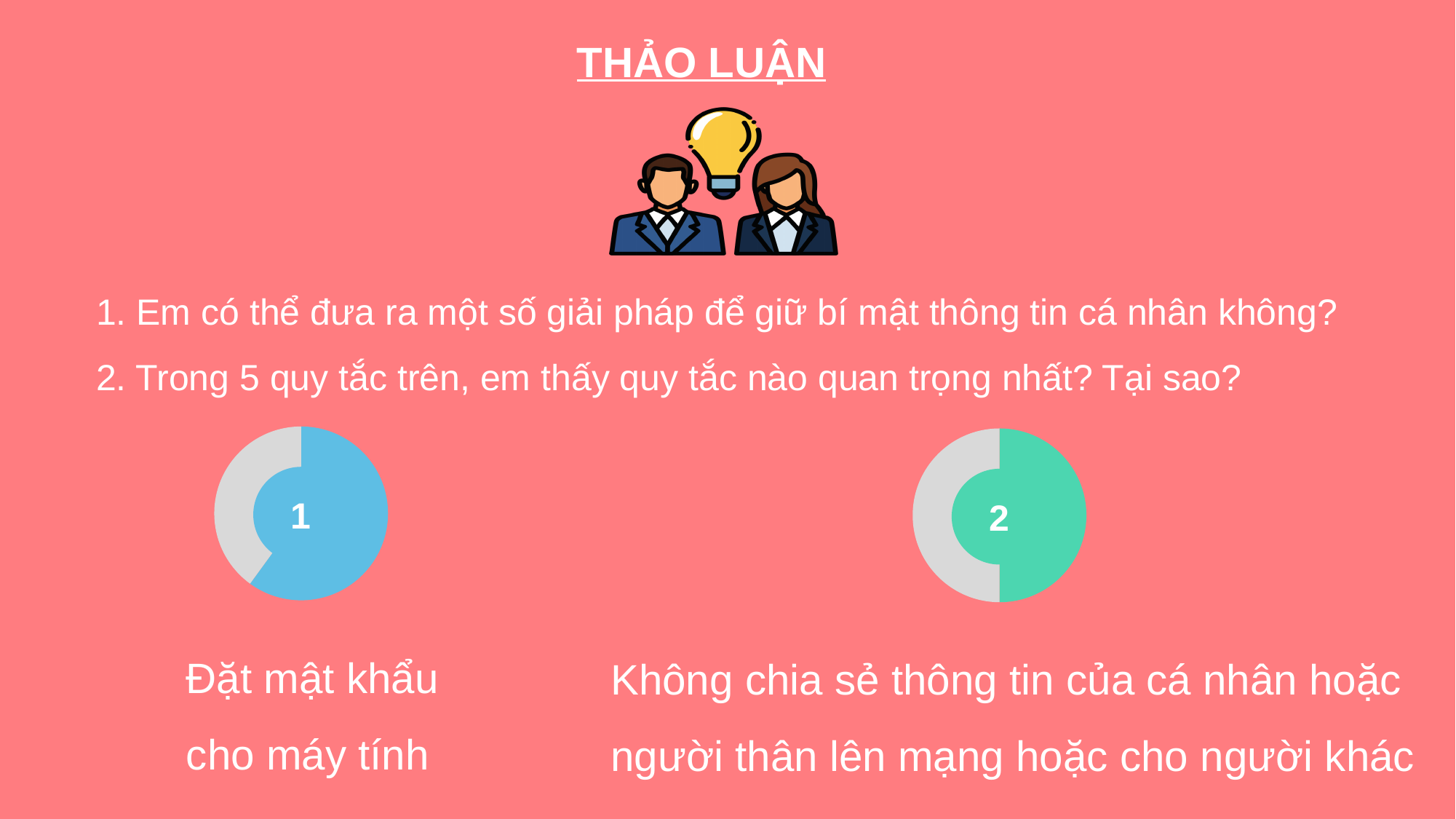
What colour is the filled portion of the ring labelled 1? blue What number is printed in the centre of the left ring? 1 What number is printed in the centre of the right ring? 2 How many ring-shaped (donut) graphics are shown on the slide? 2 Which ring has the larger filled portion, the one labelled 1 or the one labelled 2? 1 What kind of chart shape is used for the graphics labelled 1 and 2? donut chart What colour is the filled portion of the ring labelled 2? green